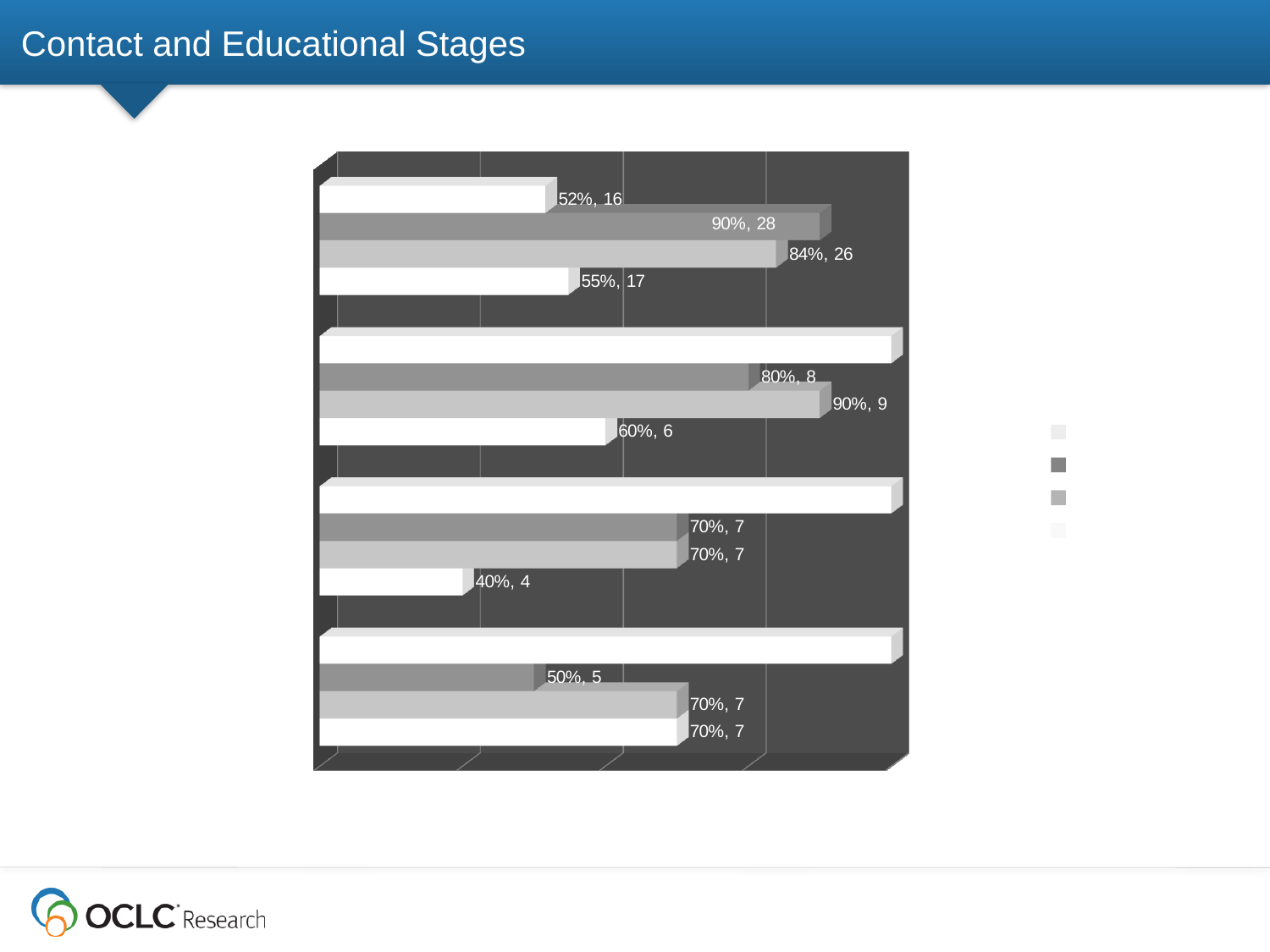
What kind of chart is shown on the slide? bar chart How many groups of bars does the chart contain? 4 What is the data label on the bottom bar of the second group from the top? 60%, 6 What is the data label on the topmost bar of the chart? 52%, 16 What is the data label on the second bar of the bottom group? 50%, 5 In the top group, what is the difference in count between the bar labelled 90%, 28 and the bar labelled 84%, 26? 2 What is the data label on the bottom bar of the top group? 55%, 17 In the second group from the top, what is the difference in percentage between the bar labelled 90%, 9 and the bar labelled 60%, 6? 30% In the top group, which bar has the highest percentage: the second bar (90%, 28) or the third bar (84%, 26)? the second bar (90%, 28) How many entries does the chart's legend list? 4 What is the data label on the second bar from the top in the top group? 90%, 28 What is the data label on the bottom bar of the third group from the top? 40%, 4